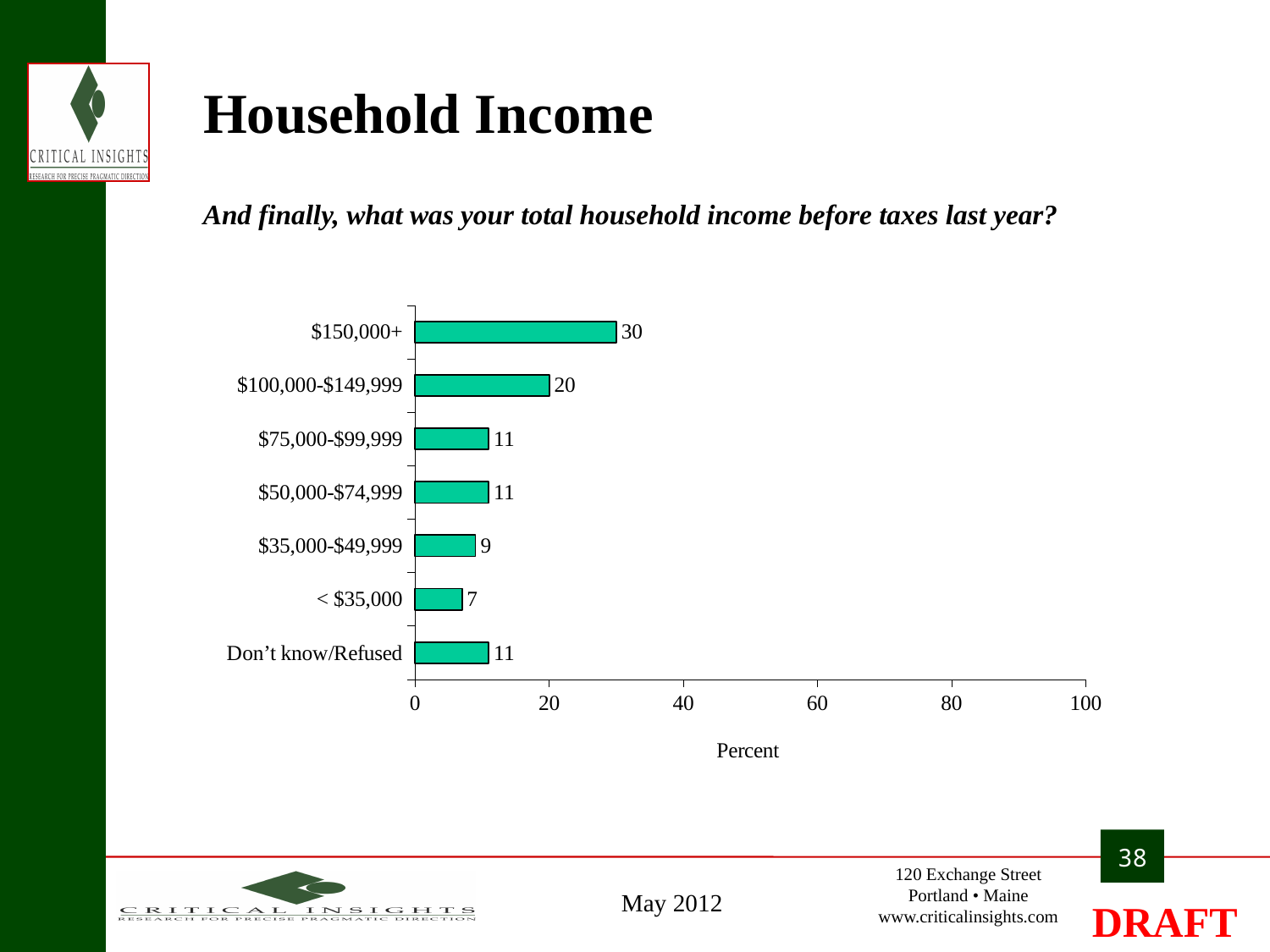
What percent of respondents answered Don't know/Refused? 11 Which income category has the lowest value? < $35,000 What is the difference between the values for $150,000+ and $100,000-$149,999? 10 What percent of respondents reported a household income of $150,000+? 30 Which is larger, the value for $35,000-$49,999 or the value for $50,000-$74,999? $50,000-$74,999 What is the value for the $100,000-$149,999 category? 20 What is the value for the < $35,000 category? 7 Is the value for $150,000+ greater or less than 20? greater What kind of chart is shown on the slide? Bar chart How many categories are shown on the chart? 7 Which income category has the highest value? $150,000+ What is the label on the horizontal axis of the chart? Percent